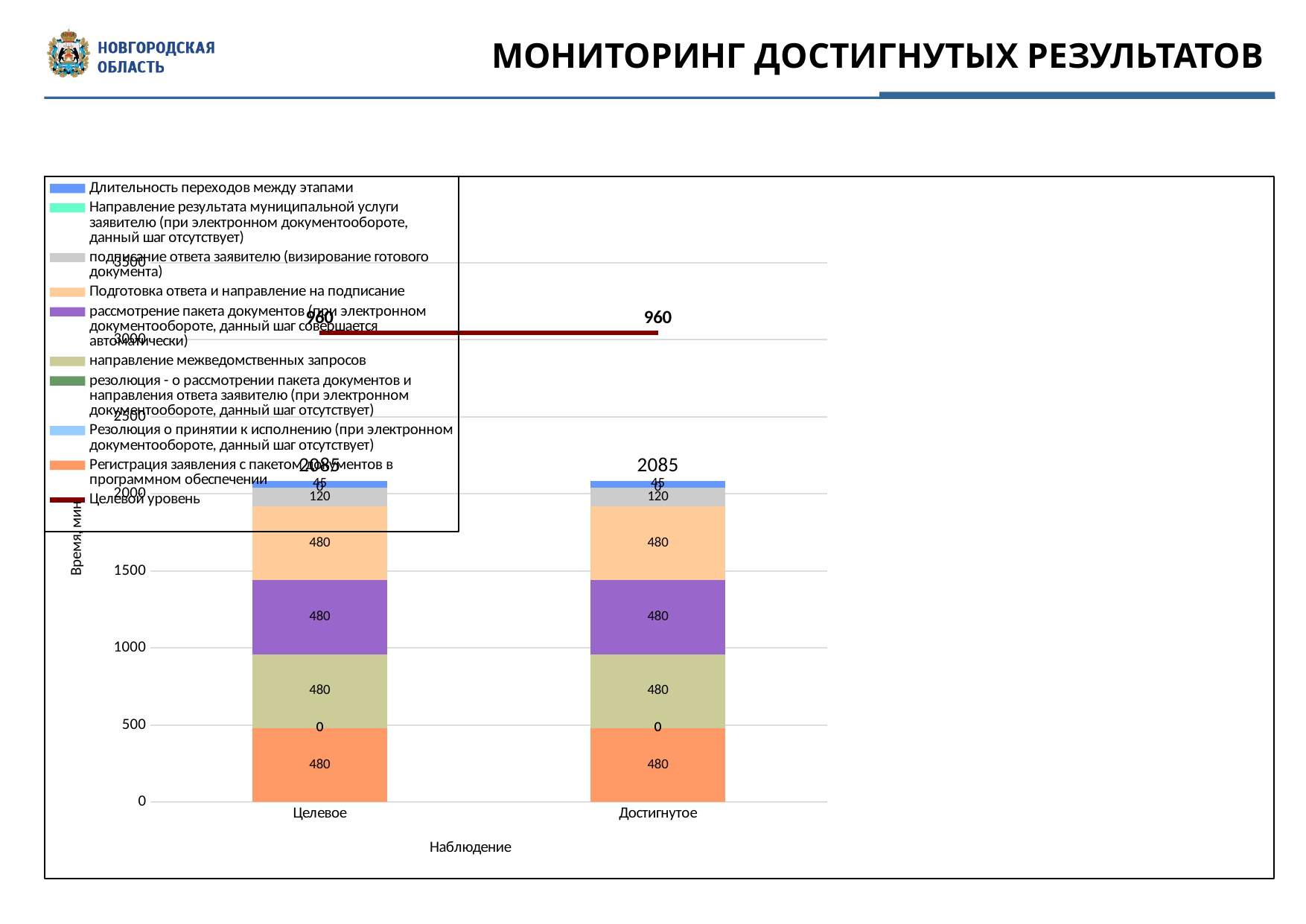
Is the total value for Целевое greater or less than 2000? greater What is the value of the Регистрация заявления с пакетом документов в программном обеспечении segment for Целевое? 480 What kind of chart is shown on the slide? Stacked bar chart What is the label of the vertical axis of the chart? Время, мин What is the difference between the total for Достигнутое and the Целевой уровень value? 1125 What is the total value of the stacked bar for Целевое? 2085 What is the total value of the stacked bar for Достигнутое? 2085 What is the value of the подписание ответа заявителю segment for Достигнутое? 120 How many entries does the chart's legend list? 10 What value is shown for the Целевой уровень line? 960 What is the value of the Длительность переходов между этапами segment for Целевое? 45 How many categories are shown on the x axis of the chart? 2